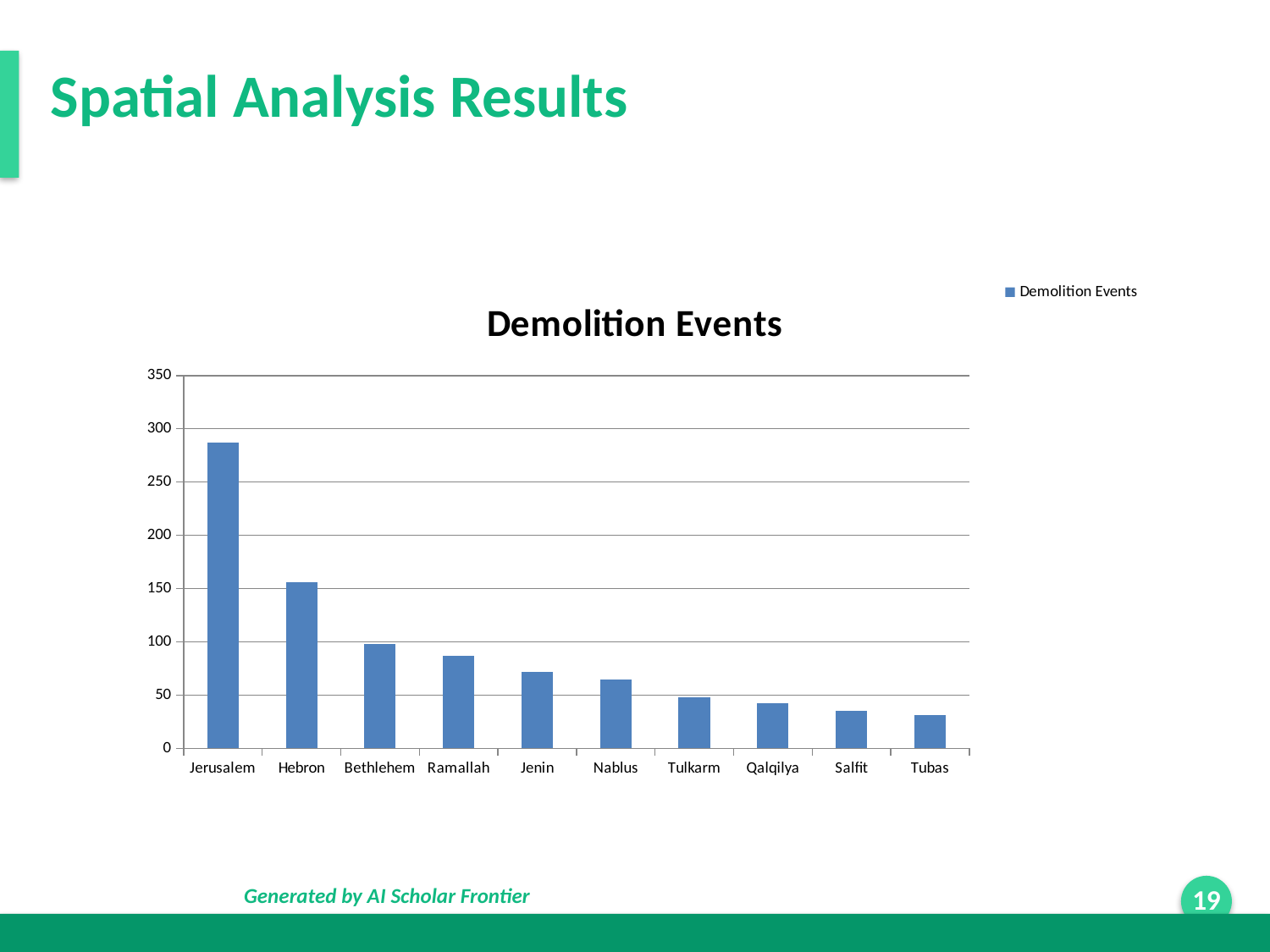
Is the value for Hebron greater or less than 200? less How many series does the legend list? 1 Is the value for Jerusalem greater or less than 250? greater Which has a higher value, Nablus or Tulkarm? Nablus What kind of chart is shown on the slide? bar chart Is the value for Tubas greater or less than 50? less Do the values rise or fall from Jerusalem to Tubas along the x axis? fall Which category has the highest value in the Demolition Events chart? Jerusalem Which has a higher value, Hebron or Bethlehem? Hebron How many categories are shown on the x axis of the chart? 10 Which category has the lowest value in the Demolition Events chart? Tubas